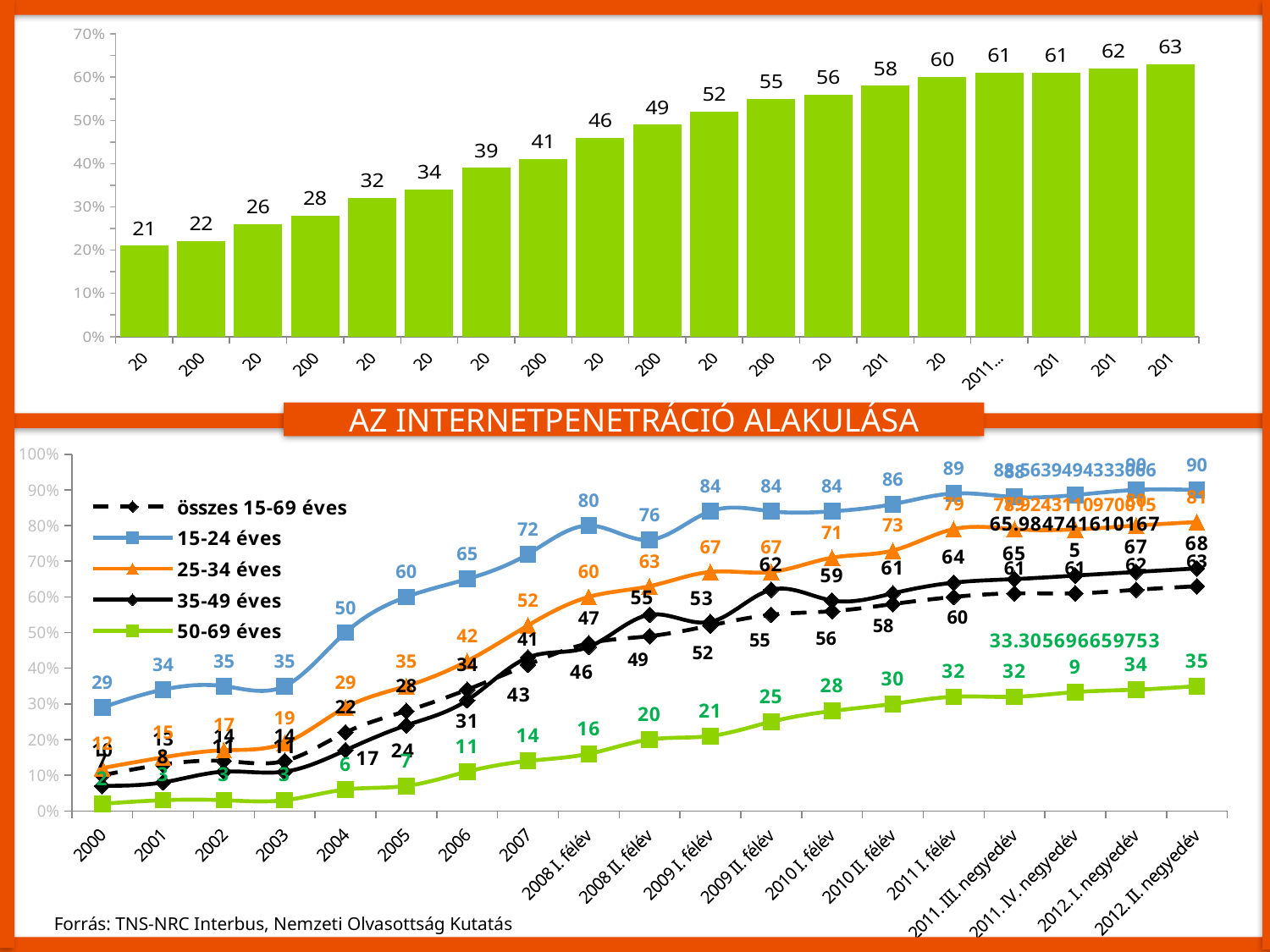
In the bottom chart, what is the value for 15-24 éves in 2007? 72 In the top chart, what is the highest value shown? 63 In the bottom chart, which series has the highest value in 2010 I. félév? 15-24 éves How many series does the legend of the bottom chart list? 5 What kind of chart is the top chart on the slide? bar chart In the top chart, what is the lowest value shown? 21 In the bottom chart, what is the difference between 15-24 éves and 50-69 éves in 2007? 58 In the bottom chart, what is the value for 25-34 éves in 2008 I. félév? 60 In the top chart, what is the difference between the last bar (63) and the first bar (21)? 42 How many bars does the top chart show? 19 In the top chart, do the values rise or fall from left to right? rise In the bottom chart, what is the value for 50-69 éves in 2012. II. negyedév? 35